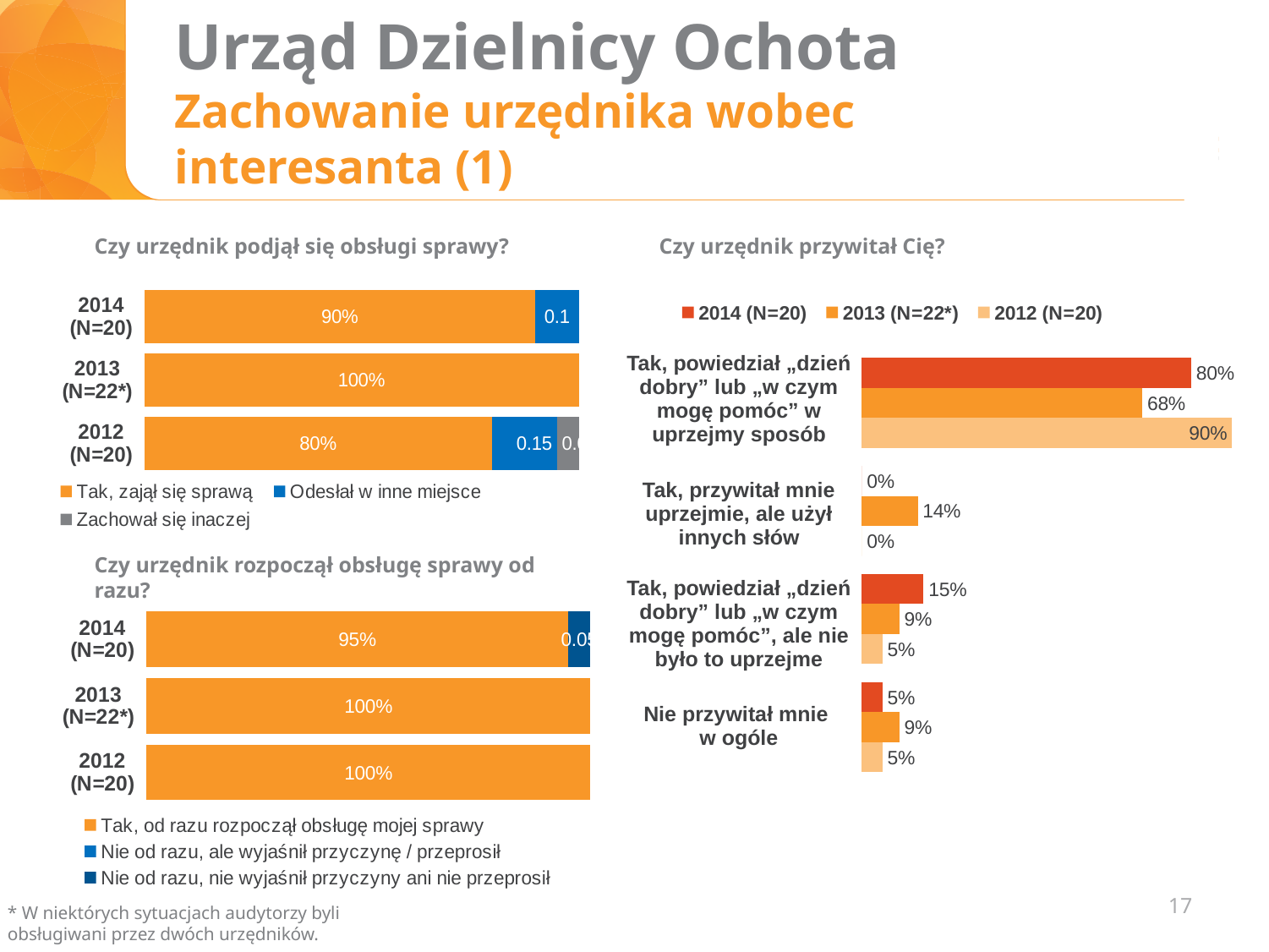
In the chart "Czy urzędnik przywitał Cię?", is the 2014 (N=20) value for "Nie przywitał mnie w ogóle" larger or smaller than the 2013 (N=22*) value? smaller In the chart "Czy urzędnik podjął się obsługi sprawy?", what share of the 2012 (N=20) bar is "Tak, zajął się sprawą"? 80% In the chart "Czy urzędnik podjął się obsługi sprawy?", which year has the highest value for "Tak, zajął się sprawą"? 2013 (N=22*) In the chart "Czy urzędnik przywitał Cię?", which year has the highest value in the category "Tak, powiedział „dzień dobry” lub „w czym mogę pomóc” w uprzejmy sposób"? 2012 (N=20) In the chart "Czy urzędnik przywitał Cię?", how many series does the legend list? 3 In the chart "Czy urzędnik przywitał Cię?", what is the value for 2012 (N=20) in the category "Tak, powiedział „dzień dobry” lub „w czym mogę pomóc” w uprzejmy sposób"? 90% What type of chart is "Czy urzędnik rozpoczął obsługę sprawy od razu?"? Stacked bar chart In the chart "Czy urzędnik przywitał Cię?", what is the value for 2013 (N=22*) in the category "Tak, przywitał mnie uprzejmie, ale użył innych słów"? 14% In the chart "Czy urzędnik przywitał Cię?", how many response categories are shown? 4 In the chart "Czy urzędnik przywitał Cię?", what is the difference between the 2014 (N=20) and 2013 (N=22*) values in the category "Tak, powiedział „dzień dobry” lub „w czym mogę pomóc” w uprzejmy sposób"? 12 percentage points In the chart "Czy urzędnik podjął się obsługi sprawy?", what colour represents "Odesłał w inne miejsce"? Blue In the chart "Czy urzędnik rozpoczął obsługę sprawy od razu?", what is the value for "Tak, od razu rozpoczął obsługę mojej sprawy" in 2014 (N=20)? 95%